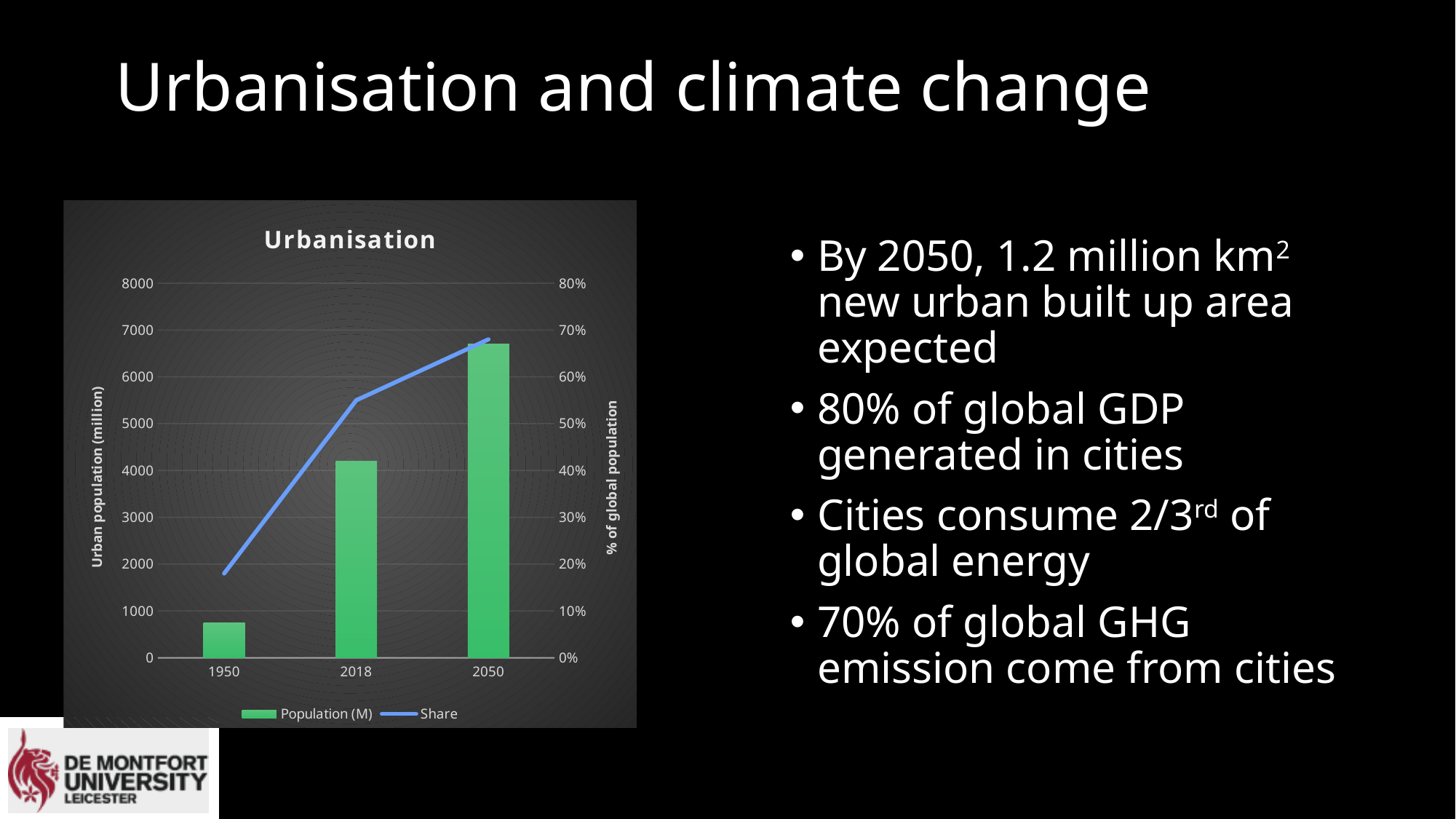
Is the Population (M) value for 1950 greater or less than 1000? less Which is larger in the chart, the Population (M) bar for 2018 or for 2050? 2050 Does the Share line rise or fall from 1950 to 2050? rise How many categories are shown on the x axis of the chart? 3 Which year has the highest Population (M) bar in the chart? 2050 Is the Population (M) value for 2050 greater or less than 7000? less Which year has the lowest Population (M) bar in the chart? 1950 Is the Share value for 1950 greater or less than 20%? less How many series does the chart's legend list? 2 What is the title of the chart on the slide? Urbanisation